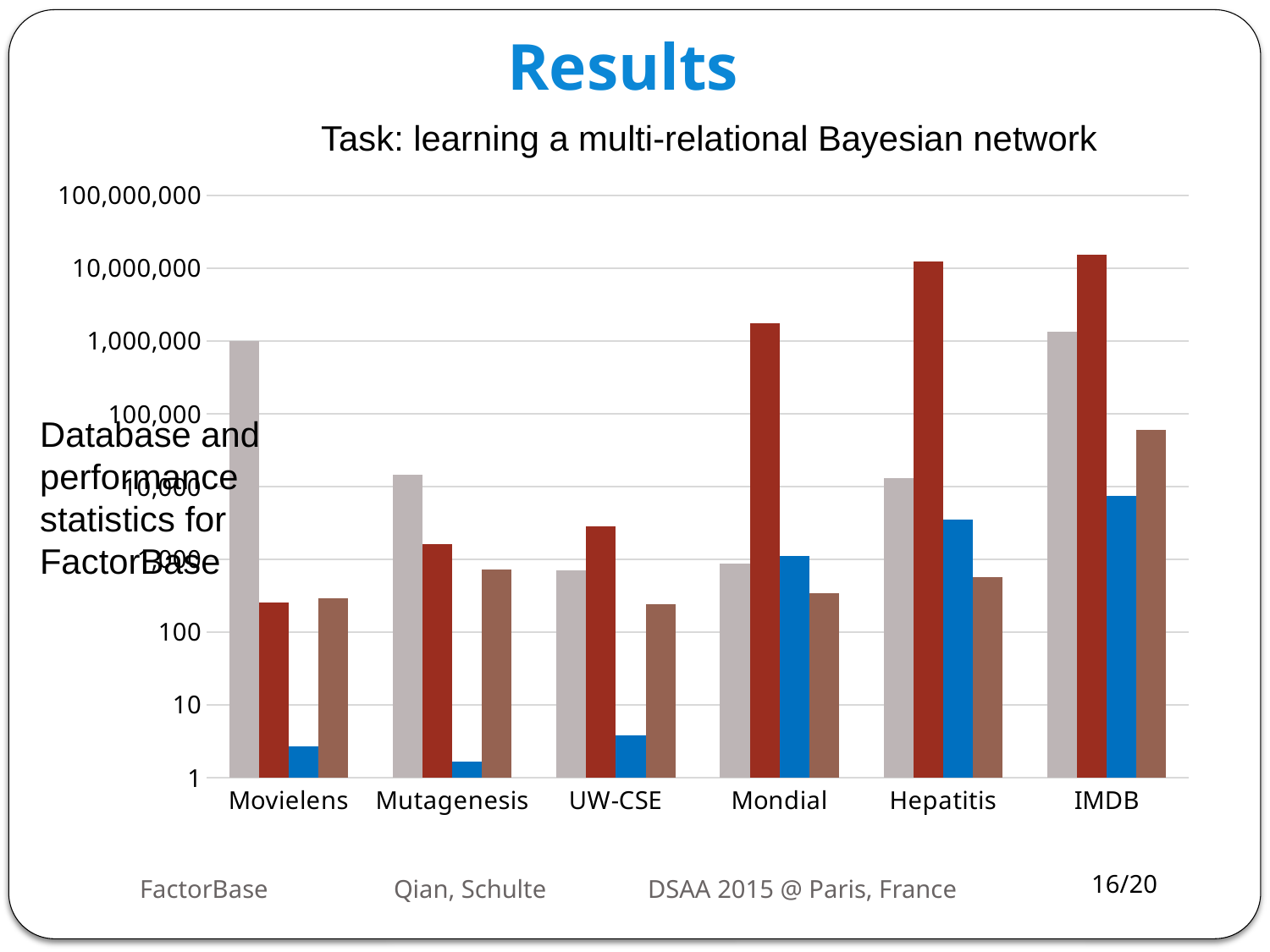
What is the highest value labelled on the y axis of the chart? 100,000,000 What is the title shown above the chart? Task: learning a multi-relational Bayesian network Is the blue bar for UW-CSE greater or less than 10? less Which category has the highest brown bar? IMDB How many bars are plotted for each category in the chart? 4 For Mondial, which is larger: the grey bar or the dark red bar? the dark red bar What kind of chart is shown on the slide? bar chart Which category has the lowest blue bar? Mutagenesis How many categories are shown on the x axis of the chart? 6 Which category has the highest blue bar? IMDB Is the dark red bar for Hepatitis greater or less than 10,000,000? greater Which category has the lowest dark red bar? Movielens